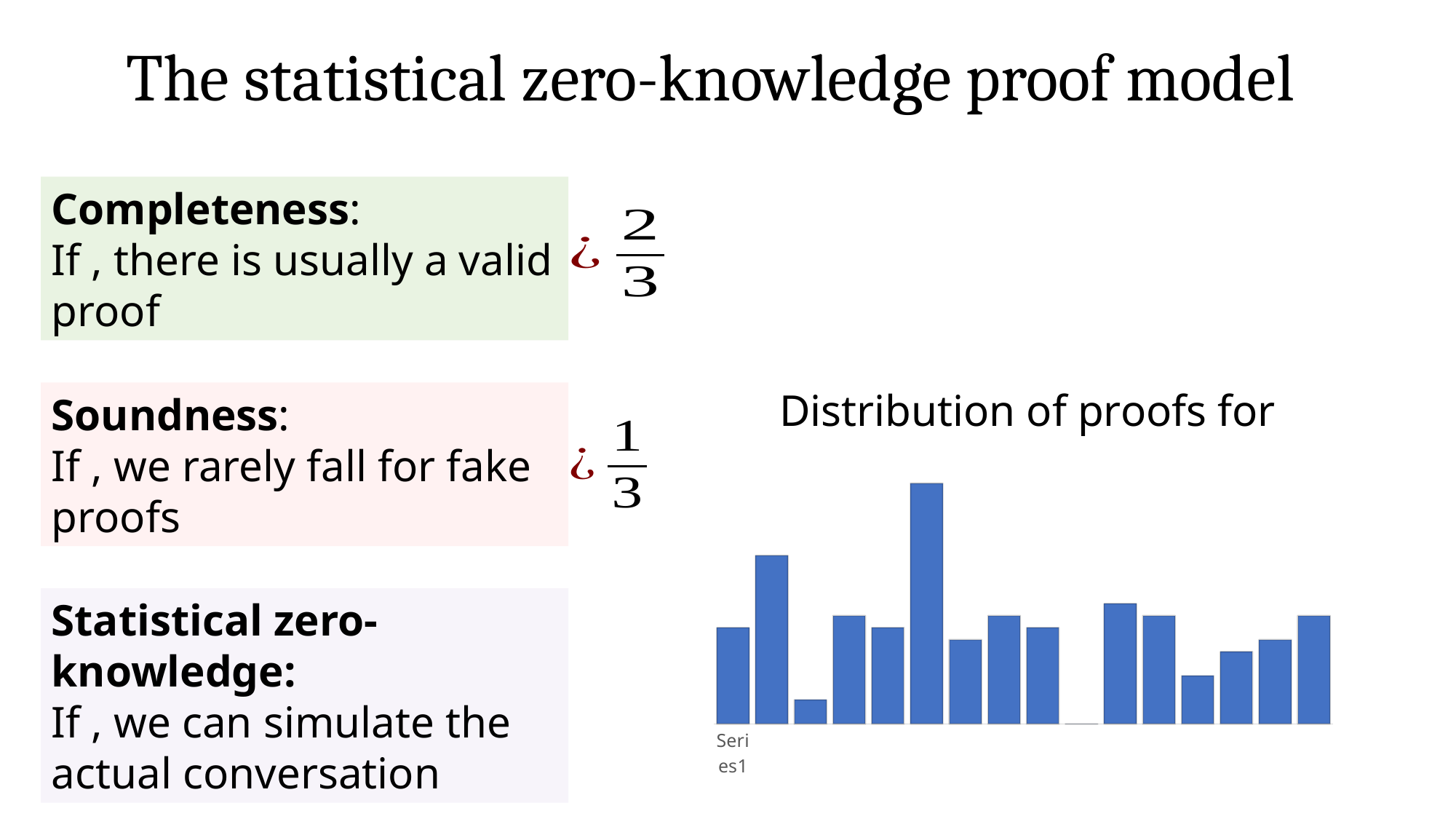
What kind of chart is shown on the slide? bar chart What is the title of the chart on the slide? Distribution of proofs for Counting from the left, which bar in the chart is the tallest? the sixth bar Is the third bar from the left taller or shorter than the first bar from the left? shorter Is the second bar from the left taller or shorter than the sixth bar from the left? shorter What is the name of the series shown in the chart's legend? Series1 How many series does the chart's legend list? 1